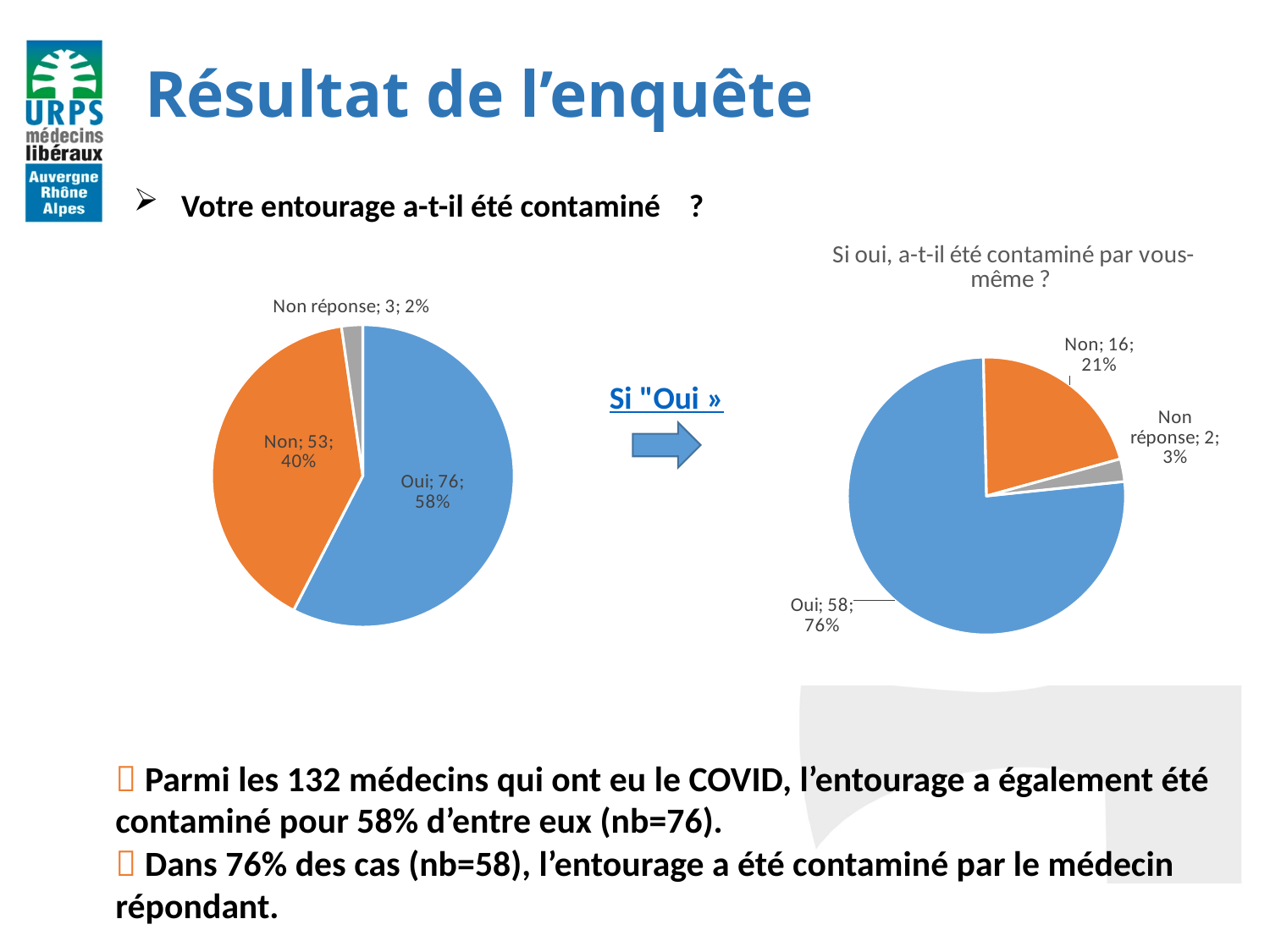
In the chart titled "Si oui, a-t-il été contaminé par vous-même ?", what is the difference between the counts for "Oui" and "Non"? 42 In the left pie chart, how many respondents answered "Oui"? 76 In the left pie chart, what percentage share does "Non" have? 40% In the left pie chart, which category has the smallest slice? Non réponse In the chart titled "Si oui, a-t-il été contaminé par vous-même ?", which category has the largest slice? Oui What is the title of the pie chart on the right of the slide? Si oui, a-t-il été contaminé par vous-même ? In the chart titled "Si oui, a-t-il été contaminé par vous-même ?", which is larger, the count for "Non" or for "Non réponse"? Non In the chart titled "Si oui, a-t-il été contaminé par vous-même ?", what percentage share does "Oui" have? 76% In the left pie chart, how many categories are shown? 3 In the chart titled "Si oui, a-t-il été contaminé par vous-même ?", how many respondents answered "Non"? 16 What type of chart is used on the left of the slide? Pie chart In the left pie chart, what is the difference between the counts for "Oui" and "Non"? 23